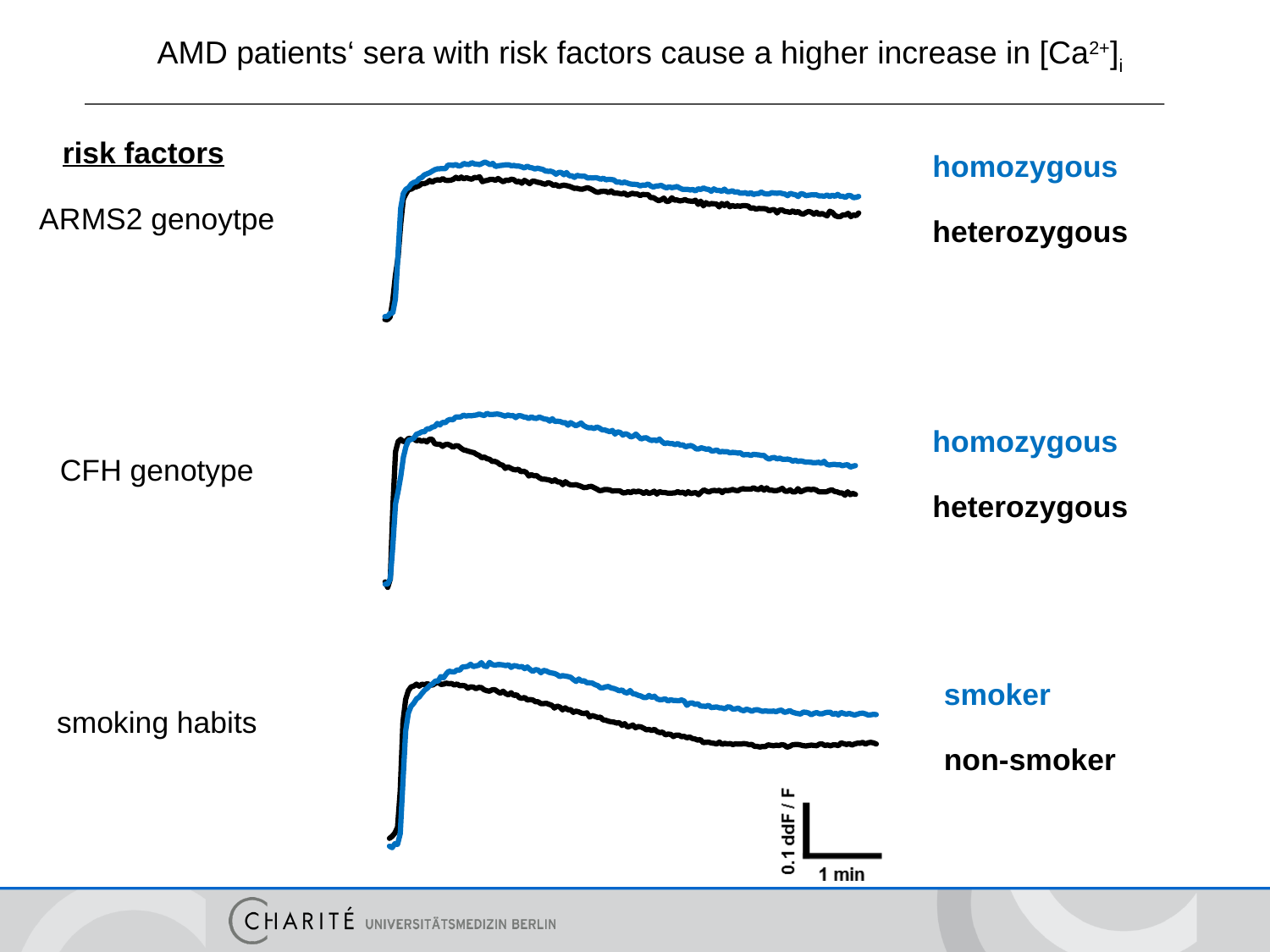
What kind of chart is used for the ARMS2 genotype panel? line chart In the ARMS2 genotype chart, which colour is used for the homozygous trace? blue In the smoking habits chart, after reaching its peak, does the smoker trace rise or fall over time? fall In the CFH genotype chart, which trace reaches the higher peak, homozygous or heterozygous? homozygous What time span does the horizontal scale bar at the bottom of the slide represent? 1 min In the smoking habits chart, which trace is higher at the end of the recording, smoker or non-smoker? smoker How many separate trace panels (charts) are shown on the slide? 3 In the smoking habits chart, which trace reaches the higher peak, smoker or non-smoker? smoker In the CFH genotype chart, how many traces (series) are plotted? 2 In the CFH genotype chart, which trace is lower at the end of the recording, homozygous or heterozygous? heterozygous In the CFH genotype chart, after the initial sharp rise, does the heterozygous trace rise or fall over time? fall